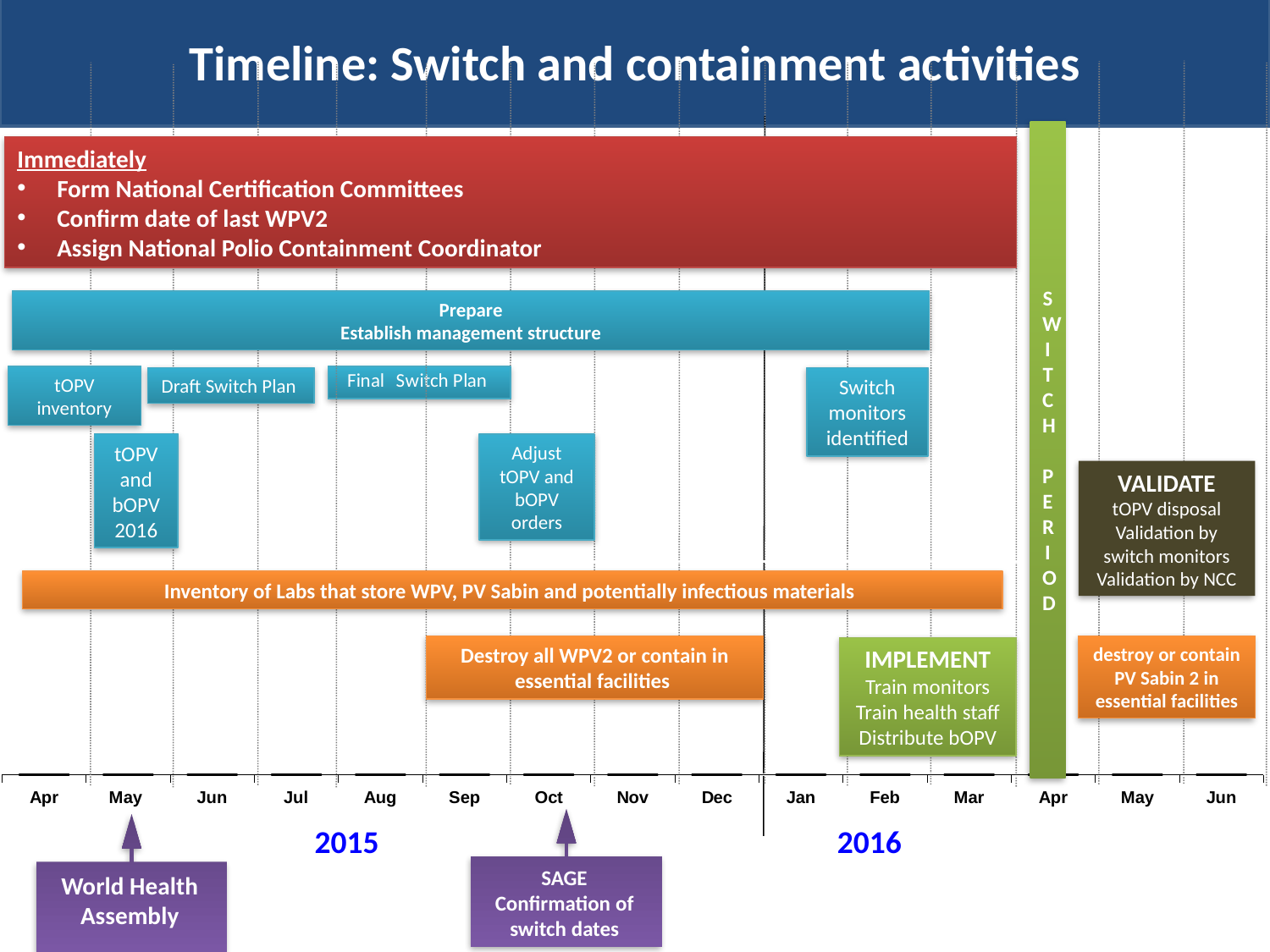
Which activity bar spans from Sep 2015 to Dec 2015? Destroy all WPV2 or contain in essential facilities In which month is the World Health Assembly marked on the timeline? May 2015 What is the first month labelled on the timeline axis? Apr In which month is the SAGE confirmation of switch dates marked on the timeline? Oct 2015 What kind of chart is shown on the slide? Timeline (Gantt chart) What colour is the vertical Switch Period bar? Green Which two years are shown on the timeline? 2015 and 2016 What is the last month labelled on the timeline axis? Jun In which month does the Switch Period bar fall on the timeline? Apr 2016 What is the title of the timeline chart? Timeline: Switch and containment activities How many months are labelled along the horizontal axis of the timeline? 15